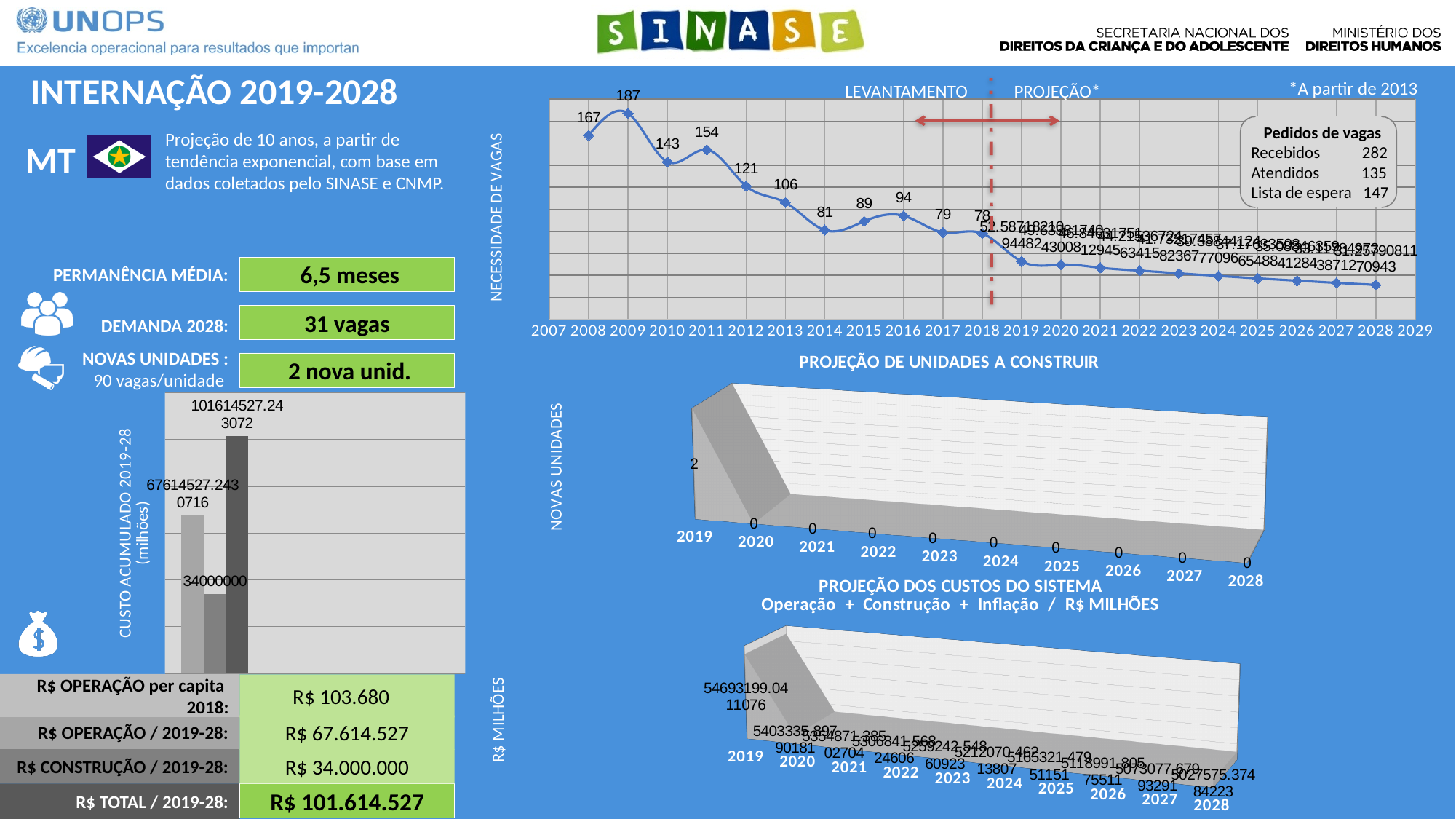
In the chart titled PROJEÇÃO DE UNIDADES A CONSTRUIR, what is the value for 2025? 0 What kind of chart is the CUSTO ACUMULADO 2019-28 chart on the left of the slide? bar chart In the top-right line chart (NECESSIDADE DE VAGAS), what is the value for 2018? 78 In the top-right line chart (NECESSIDADE DE VAGAS), what is the difference between the values for 2009 and 2008? 20 In the top-right line chart, what label is on the left side of the dashed vertical line and what label is on the right? LEVANTAMENTO and PROJEÇÃO* In the top-right line chart (NECESSIDADE DE VAGAS), what is the value for 2009? 187 In the top-right line chart (NECESSIDADE DE VAGAS), which year has the highest value? 2009 In the CUSTO ACUMULADO 2019-28 bar chart on the left, what value is printed on the shortest bar? 34000000 In the top-right line chart (NECESSIDADE DE VAGAS), which year has the larger value, 2010 or 2011? 2011 In the chart titled PROJEÇÃO DE UNIDADES A CONSTRUIR, how many years are shown on the x axis? 10 In the top-right line chart (NECESSIDADE DE VAGAS), do the values generally rise or fall from 2008 to 2028? fall In the chart titled PROJEÇÃO DE UNIDADES A CONSTRUIR, what is the value for 2019? 2